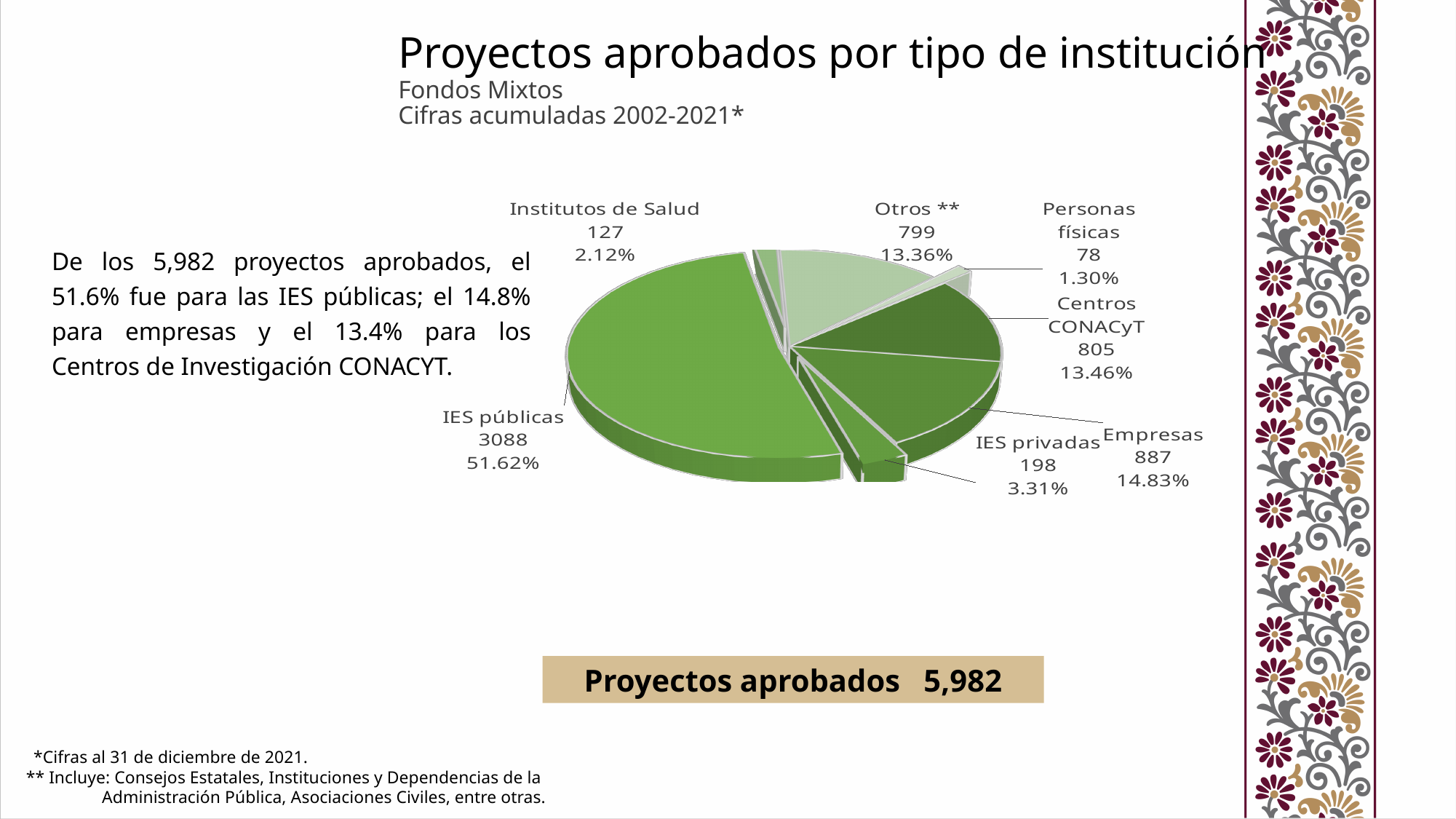
How many categories does the pie chart show? 7 Which category has the smallest slice of the pie? Personas físicas Which category has the largest slice of the pie? IES públicas What is the difference in projects between Empresas and Centros CONACyT? 82 What is the title of the chart on the slide? Proyectos aprobados por tipo de institución What percentage share does the Empresas slice have? 14.83% How many projects are shown for Centros CONACyT? 805 How many projects are shown for IES públicas? 3088 What is the difference in projects between IES privadas and Institutos de Salud? 71 What kind of chart is shown on the slide? Pie chart Which has more projects, Otros ** or IES privadas? Otros ** What percentage share does the Personas físicas slice have? 1.30%